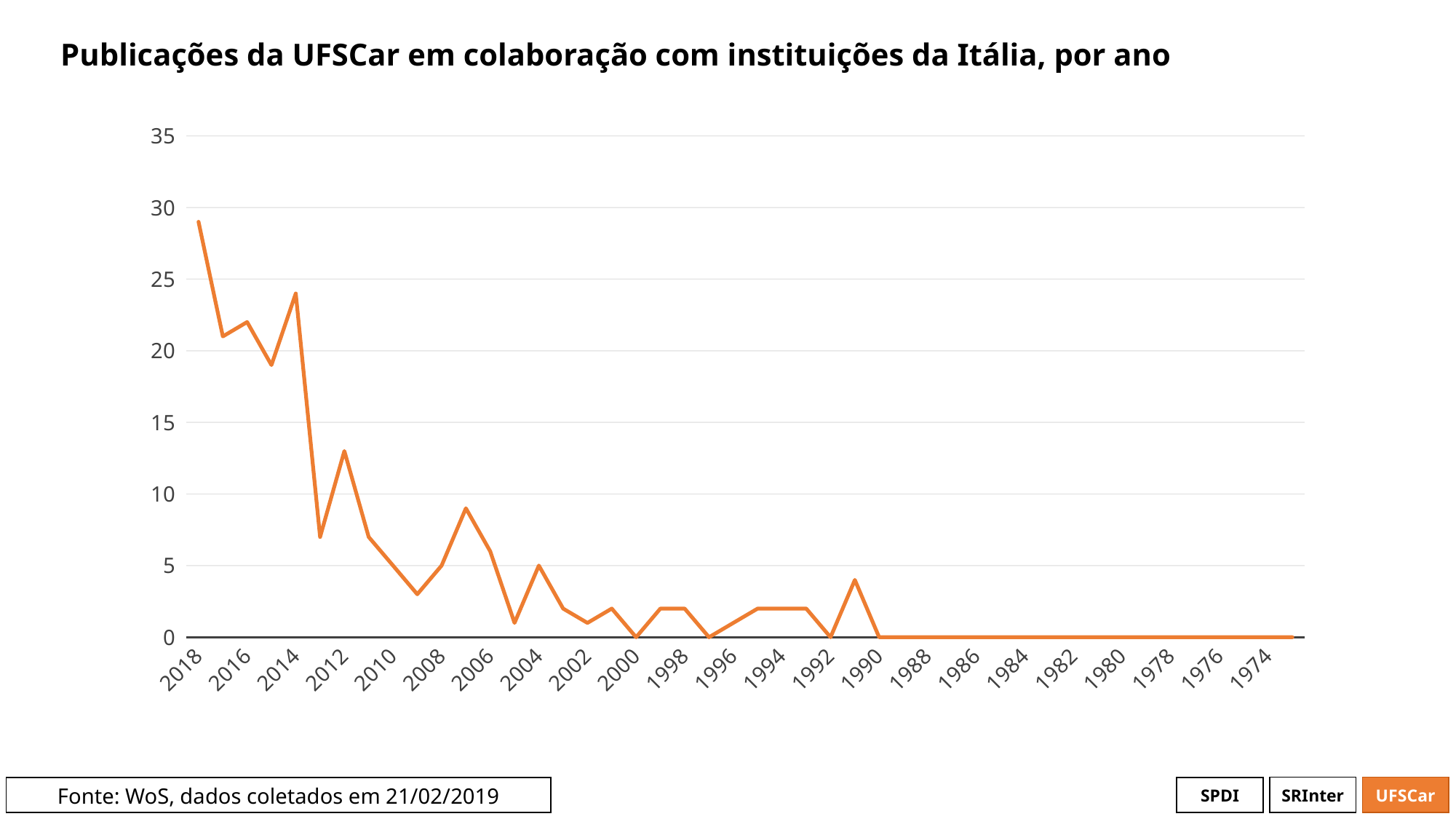
What is the value for 1988? 0 Is the value for 2015 greater or less than 20? less Moving from left (2018) to right (1974) along the x axis, do the values generally rise or fall? fall Is the value for 2014 greater or less than 20? greater What kind of chart is shown on the slide? line chart Is the value for 2018 greater or less than 25? greater Which year has the highest number of publications? 2018 Which year has the larger value, 2018 or 2012? 2018 What is the value for 2000? 0 What is the title of the chart? Publicações da UFSCar em colaboração com instituições da Itália, por ano